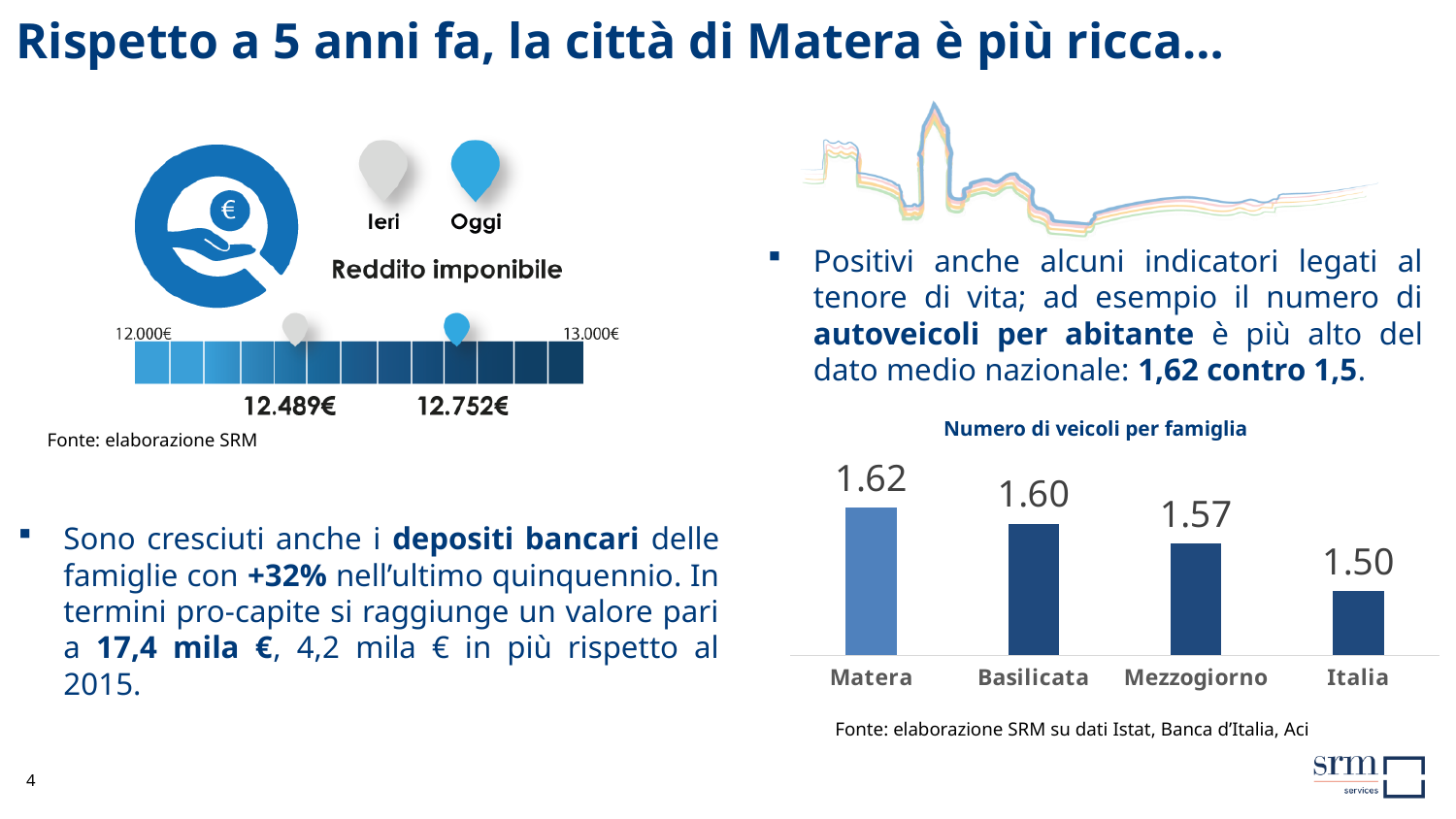
How many categories are shown in the chart 'Numero di veicoli per famiglia'? 4 In the 'Reddito imponibile' graphic on the left, what is the value for 'Ieri'? 12.489€ In the 'Reddito imponibile' graphic on the left, what is the value for 'Oggi'? 12.752€ In the chart 'Numero di veicoli per famiglia', which is larger, the value for Basilicata or the value for Mezzogiorno? Basilicata In the chart 'Numero di veicoli per famiglia', what is the value for Matera? 1.62 In the chart 'Numero di veicoli per famiglia', which category has the highest value? Matera In the chart 'Numero di veicoli per famiglia', which category has the lowest value? Italia In the chart 'Numero di veicoli per famiglia', what is the difference between the values for Matera and Italia? 0.12 What kind of chart is 'Numero di veicoli per famiglia'? bar chart In the chart 'Numero di veicoli per famiglia', do the values rise or fall from left to right? fall In the chart 'Numero di veicoli per famiglia', what is the value for Mezzogiorno? 1.57 In the chart 'Numero di veicoli per famiglia', what is the value for Italia? 1.50